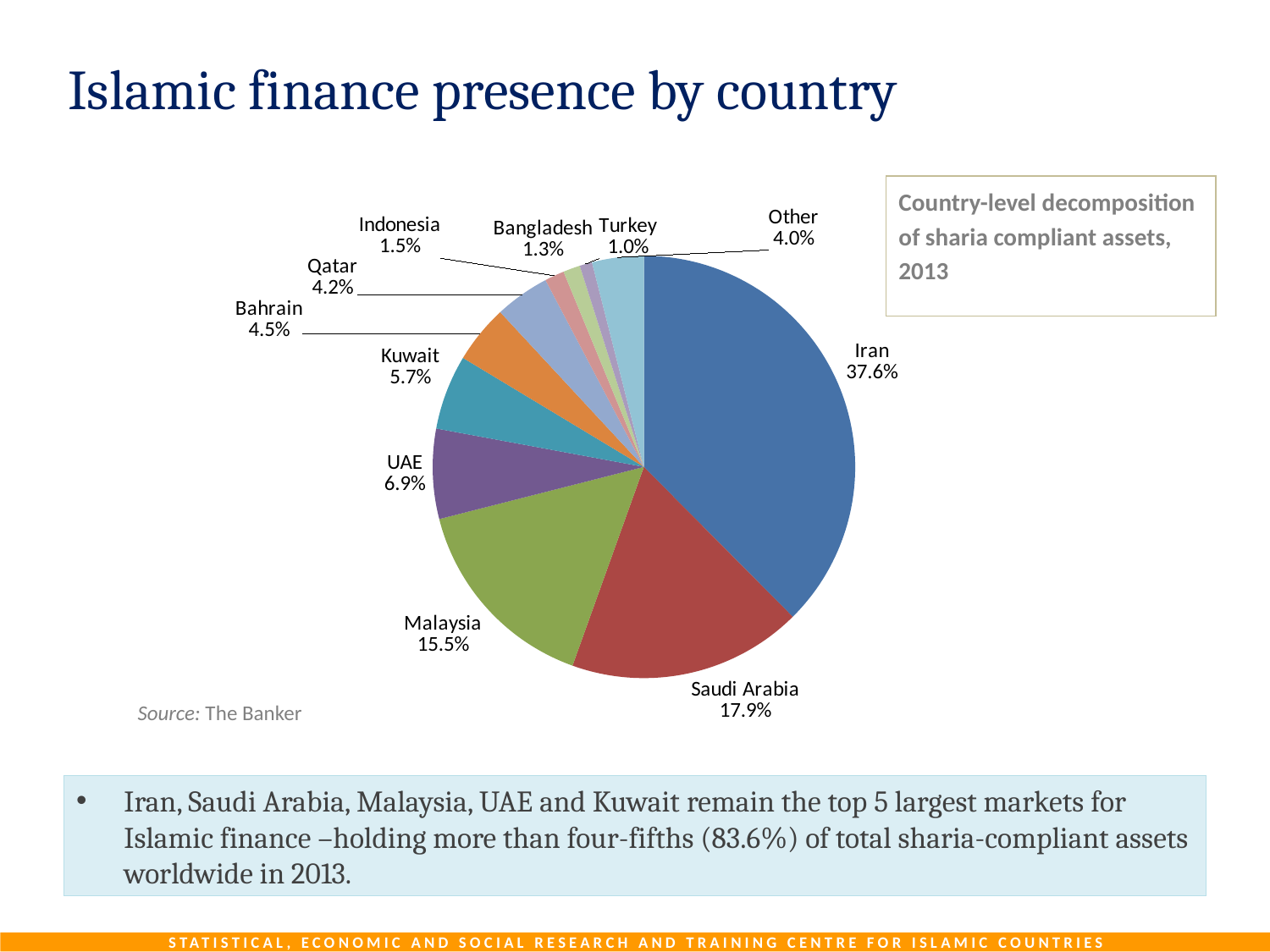
What is the difference between Saudi Arabia's share and Malaysia's share? 2.4% How many slices does the pie chart have? 11 Which is larger, the share for UAE or the share for Kuwait? UAE What is the title given in the box next to the chart? Country-level decomposition of sharia compliant assets, 2013 What is the combined share of Bahrain and Qatar? 8.7% Which named country has the smallest slice of the pie chart? Turkey What share of sharia compliant assets does Iran hold in the pie chart? 37.6% Which country has the largest slice of the pie chart? Iran What is the source cited for the chart? The Banker What percentage is shown for Kuwait? 5.7% What type of chart is shown on the slide? Pie chart What is the value shown for Malaysia in the pie chart? 15.5%